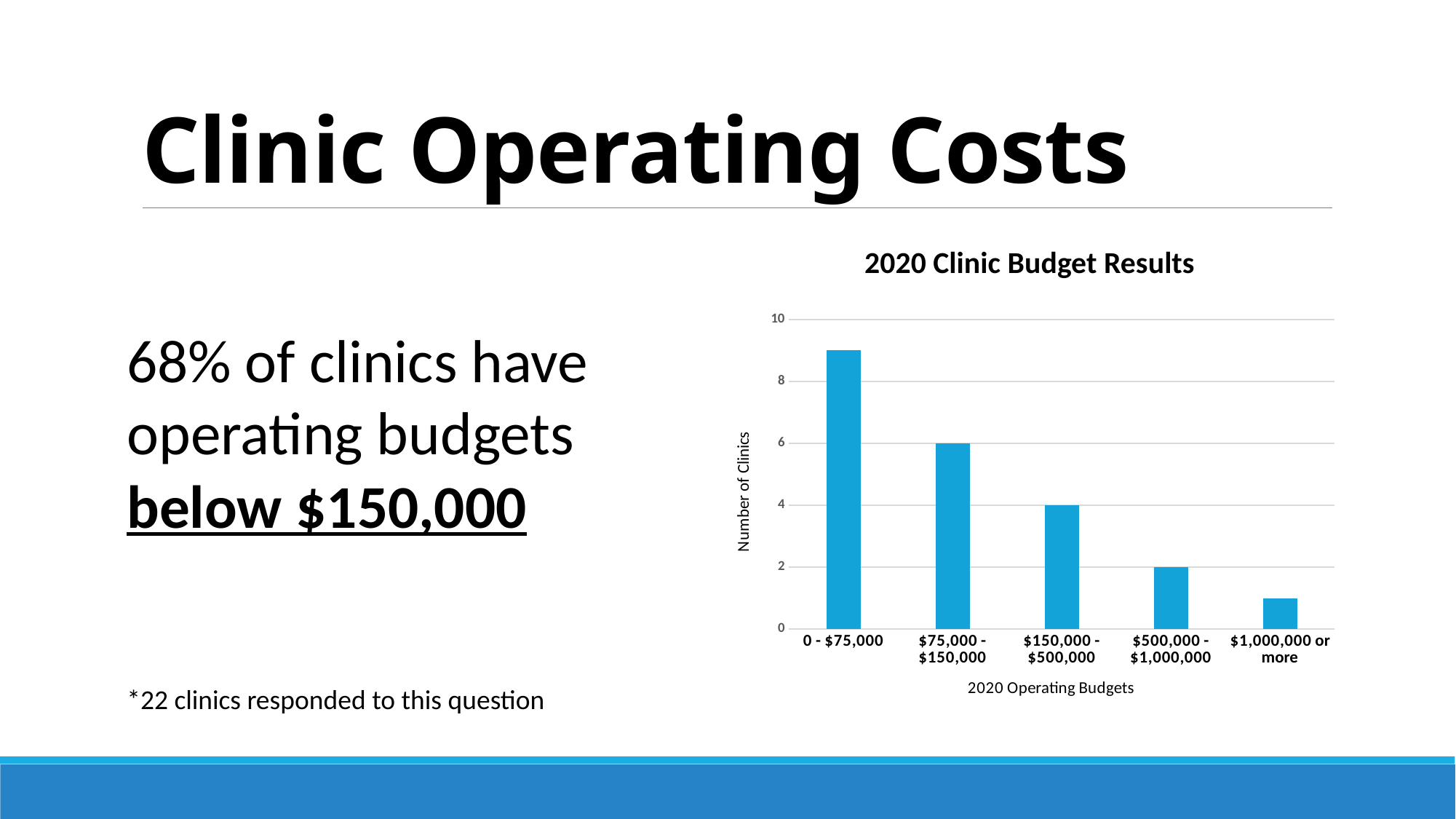
Do the number of clinics rise or fall as the operating budget categories increase along the x axis? fall How many clinics have an operating budget of $150,000 - $500,000? 4 Is the number of clinics in the 0 - $75,000 category greater or less than 8? greater How many clinics have an operating budget of $500,000 - $1,000,000? 2 How many budget categories are shown on the x axis of the chart? 5 How many clinics have an operating budget of $75,000 - $150,000? 6 What type of chart is shown on the slide? bar chart Which budget category has the lowest number of clinics? $1,000,000 or more Is the number of clinics in the $1,000,000 or more category greater or less than 2? less Which budget category has the highest number of clinics? 0 - $75,000 What is the difference in the number of clinics between the $75,000 - $150,000 and $500,000 - $1,000,000 categories? 4 What is the title of the chart? 2020 Clinic Budget Results